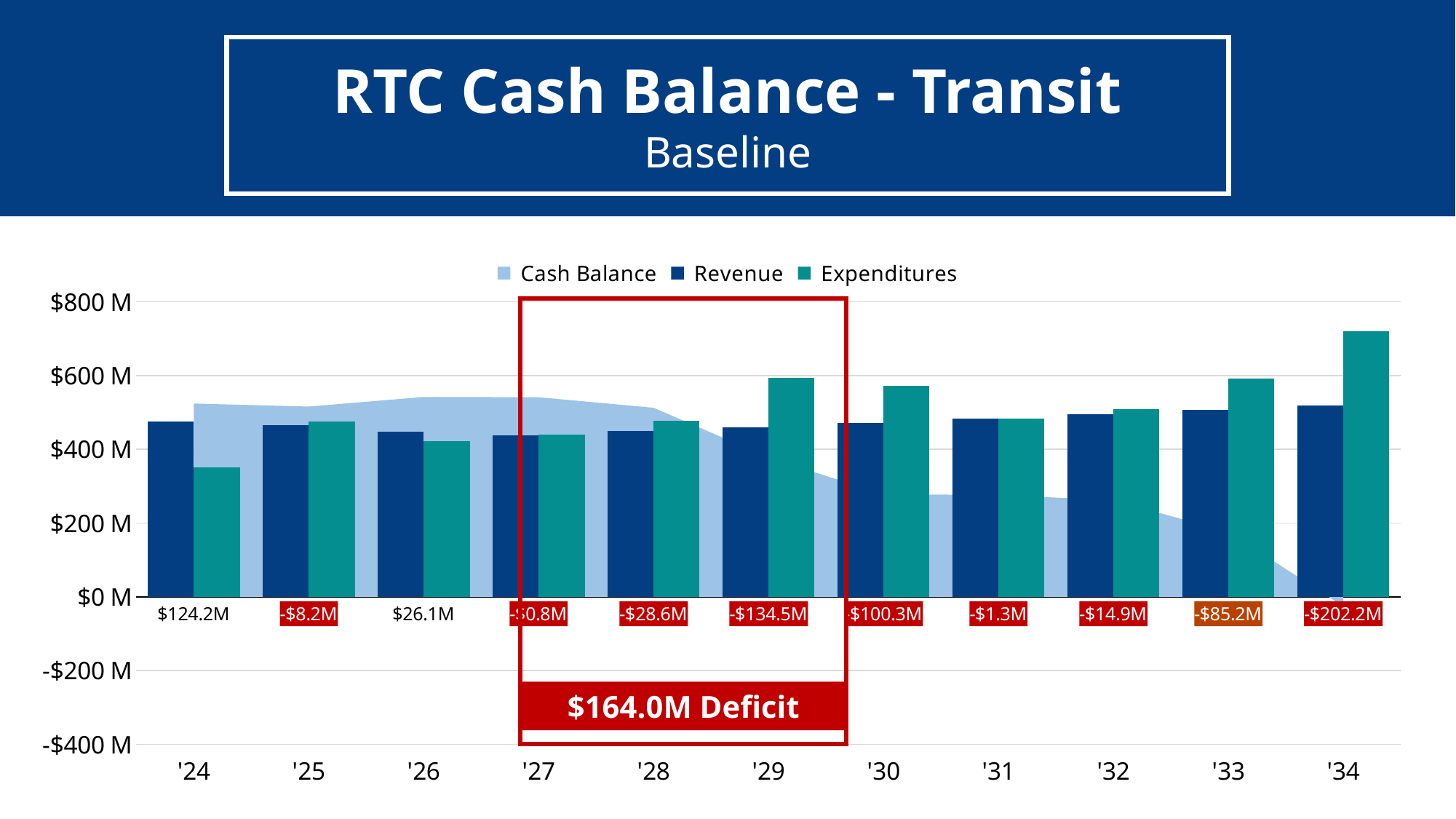
Which year has the highest Expenditures bar? '34 Which year has the lowest Expenditures bar? '24 How many series does the legend list? 3 Is the Expenditures value for '34 greater or less than $600 M? greater What deficit amount is shown in the red box covering '27 to '29? $164.0M Deficit What value is labeled below the bars for '24? $124.2M How many years are shown on the x axis? 11 In '24, which is larger, Revenue or Expenditures? Revenue What value is labeled below the bars for '34? -$202.2M What is the title of the chart on the slide? RTC Cash Balance - Transit Baseline What value is labeled below the bars for '29? -$134.5M What kind of chart is used to show Revenue and Expenditures? Bar chart